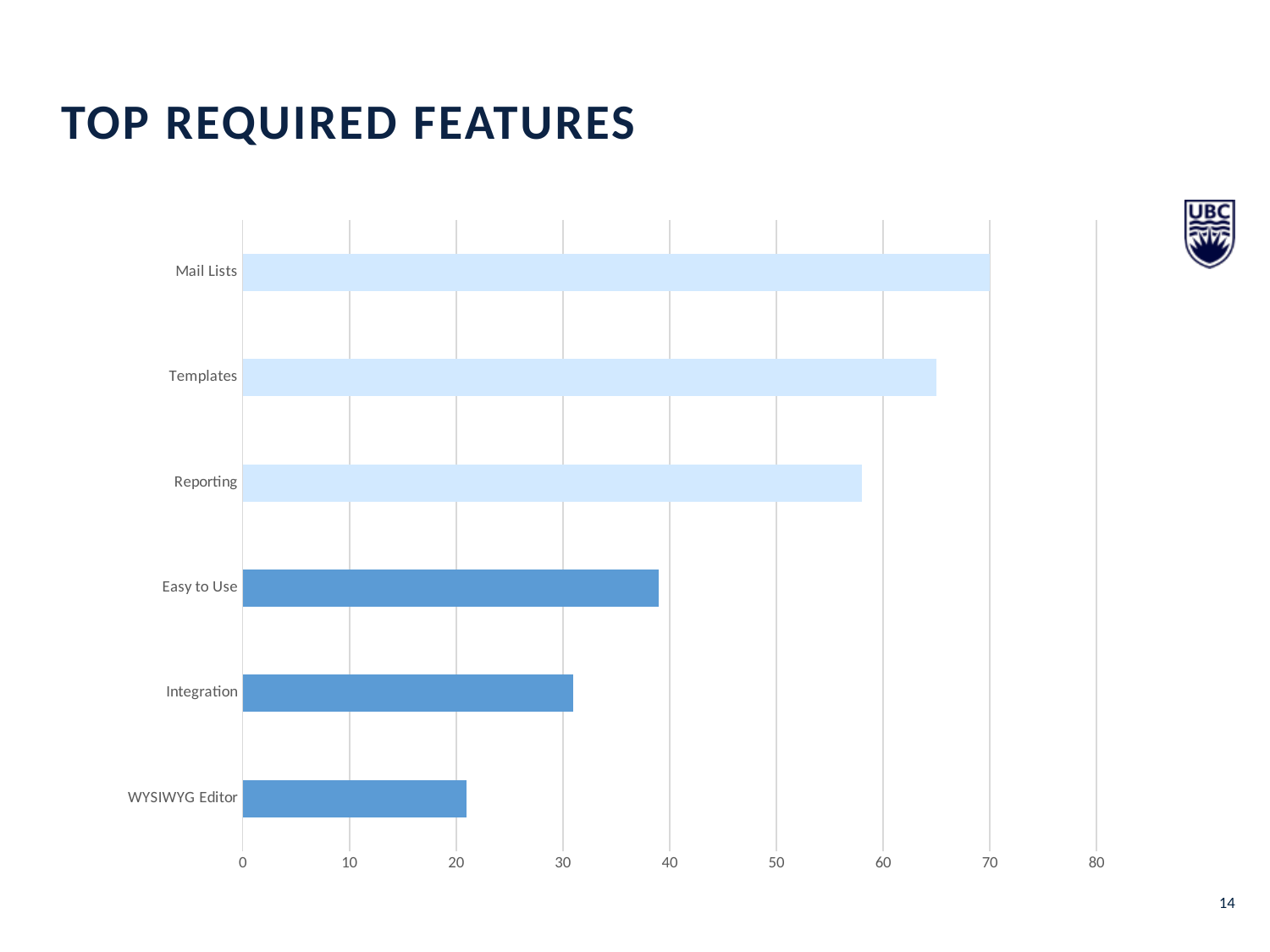
What kind of chart is shown on the slide? bar chart What is the title of the slide containing the chart? TOP REQUIRED FEATURES Which has a larger value, Templates or Reporting? Templates Which feature has the lowest value? WYSIWYG Editor Is the value for Templates greater or less than 60? greater How many features are listed on the chart? 6 Which feature has the highest value? Mail Lists What is the value for Mail Lists? 70 Is the value for Reporting greater or less than 60? less